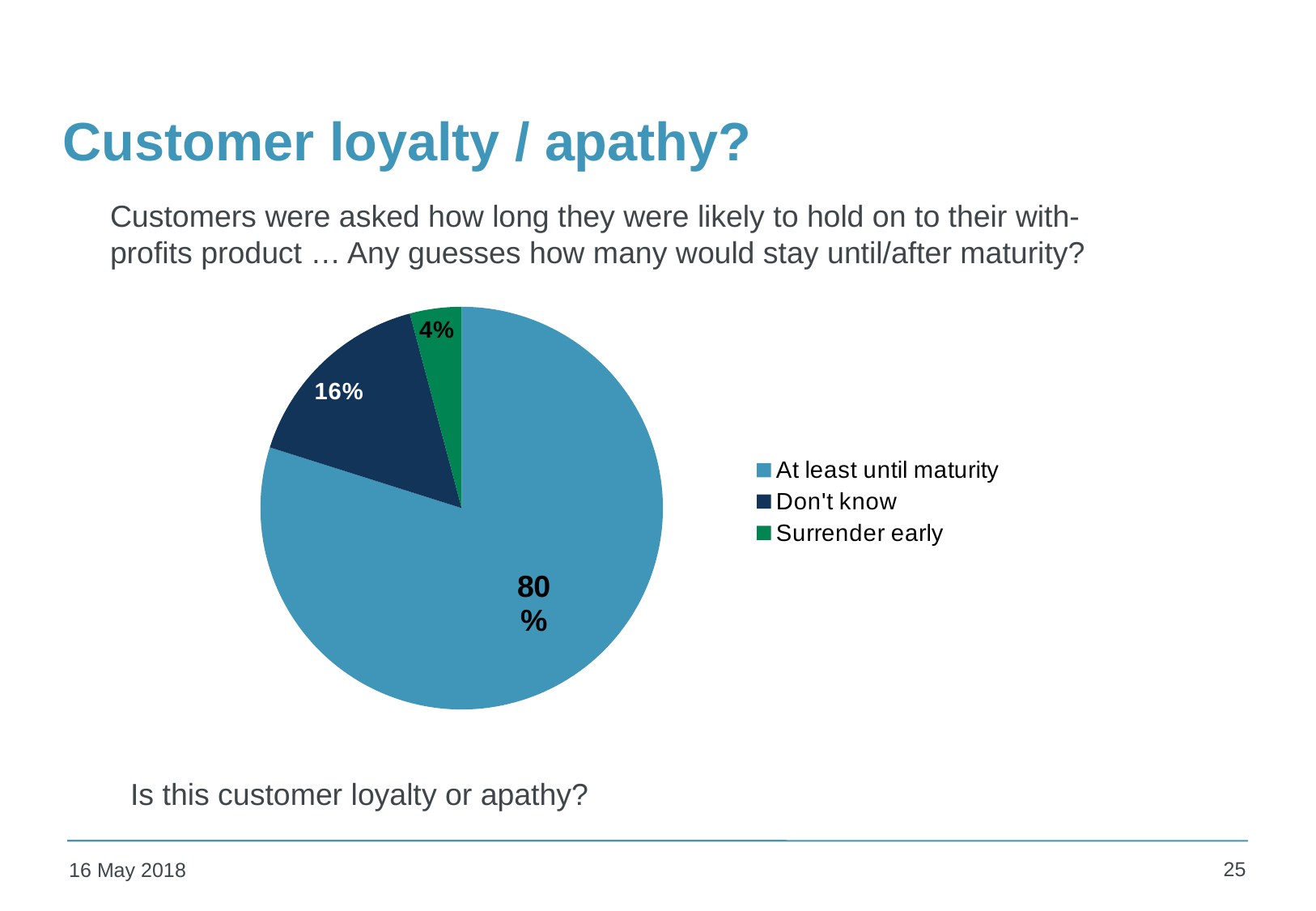
What is the difference in percentage points between 'At least until maturity' and 'Don't know'? 64 Which is larger: the 'Don't know' slice or the 'Surrender early' slice? Don't know Which category has the smallest slice of the pie? Surrender early What is the difference in percentage points between 'Don't know' and 'Surrender early'? 12 Which category has the largest slice of the pie? At least until maturity What colour is the 'Surrender early' slice? Green What is the combined share of 'Don't know' and 'Surrender early'? 20% How many categories does the pie chart show? 3 What percentage of customers said they would surrender early? 4% What percentage of customers answered 'Don't know'? 16% What kind of chart is shown on the slide? Pie chart What share of customers said they would hold their with-profits product at least until maturity? 80%